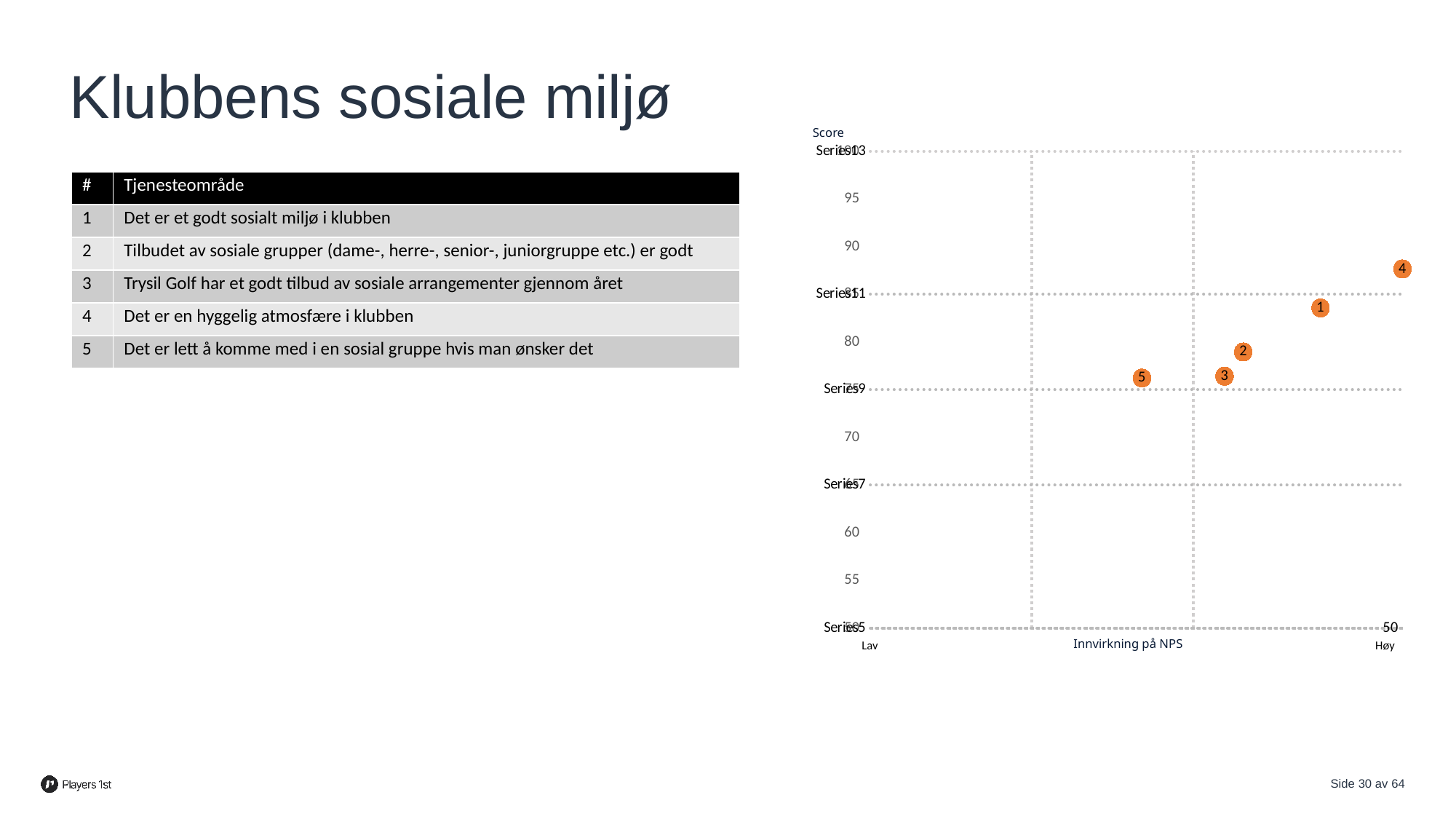
Which has the higher score, point 2 or point 5? 2 Is the score for point 5 less or greater than 80? less What kind of chart is shown on the slide? scatter chart Is the score for point 1 greater or less than 80? greater Which point has the highest score in the chart? 4 How many data points are plotted in the chart? 5 Is the score for point 4 greater or less than 85? greater What is the title of the horizontal axis of the chart? Innvirkning på NPS Which point is furthest to the left on the 'Innvirkning på NPS' axis? 5 Do the scores generally rise or fall as the impact on NPS increases from left to right? rise Which point is furthest to the right on the 'Innvirkning på NPS' axis? 4